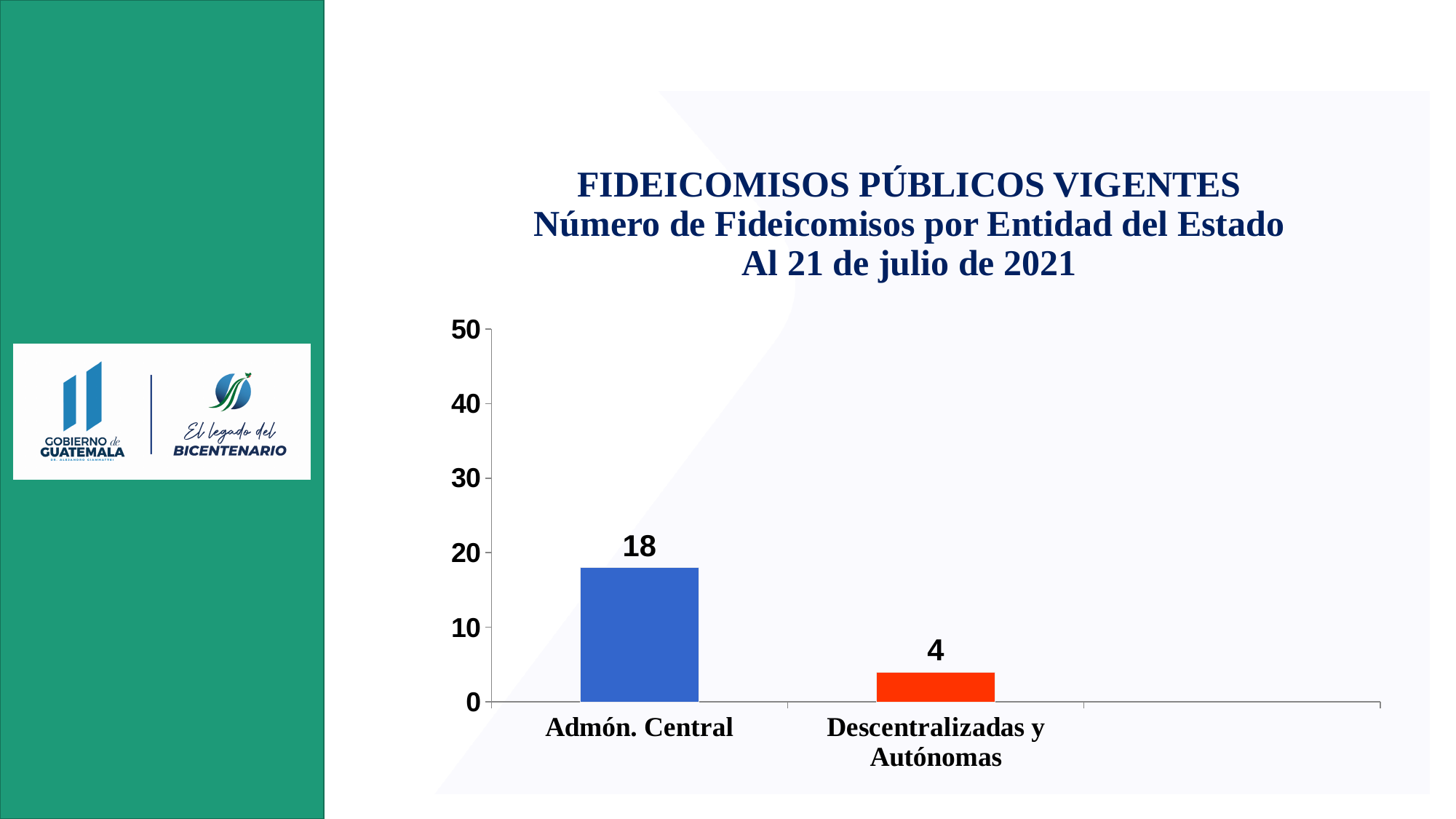
What is the value for Descentralizadas y Autónomas? 4 Which category has the lowest value? Descentralizadas y Autónomas What is the difference between the values for Admón. Central and Descentralizadas y Autónomas? 14 Which is larger, the value for Admón. Central or the value for Descentralizadas y Autónomas? Admón. Central Which category has the highest value? Admón. Central Is the value for Descentralizadas y Autónomas greater or less than 10? less Is the value for Admón. Central greater or less than 20? less What is the maximum value shown on the y axis? 50 What kind of chart is shown on the slide? bar chart How many categories are shown on the x axis? 2 What is the value for Admón. Central? 18 What colour is the bar for Descentralizadas y Autónomas? orange-red